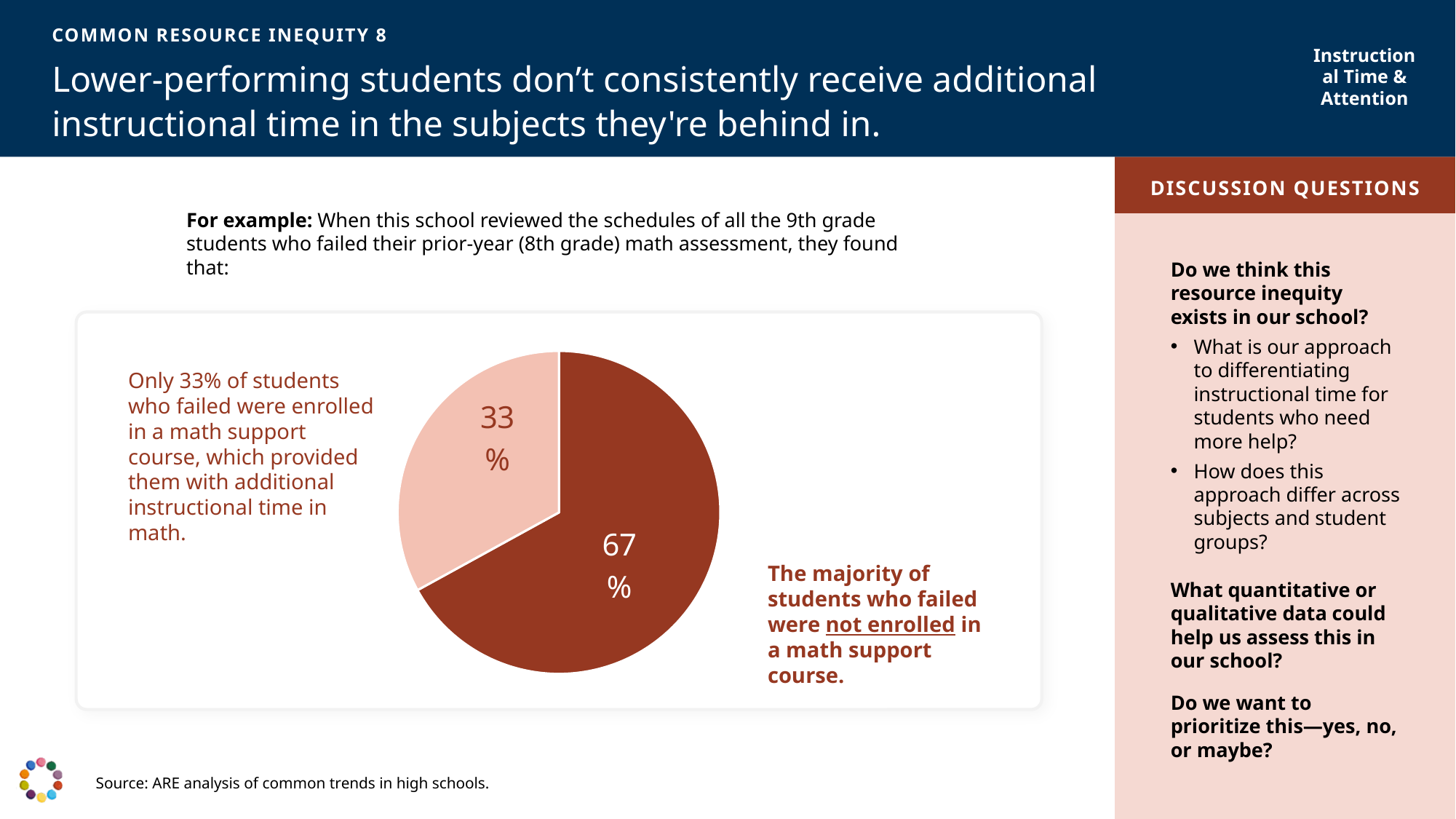
What is the difference in percentage points between the two slices of the pie chart? 34 What is the total of the two slices shown in the pie chart? 100% What colour is the slice labelled 67%? dark red Which slice of the pie chart is the smallest? 33% (enrolled in a math support course) How many slices does the pie chart have? 2 What share of the pie represents students who failed and were enrolled in a math support course? 33% What kind of chart is shown on the slide? pie chart What colour is the slice labelled 33%? light pink Which slice of the pie chart is the largest? 67% (not enrolled in a math support course) What share of the pie represents students who failed and were not enrolled in a math support course? 67% Which is larger: the share of students enrolled in a math support course or the share not enrolled? not enrolled